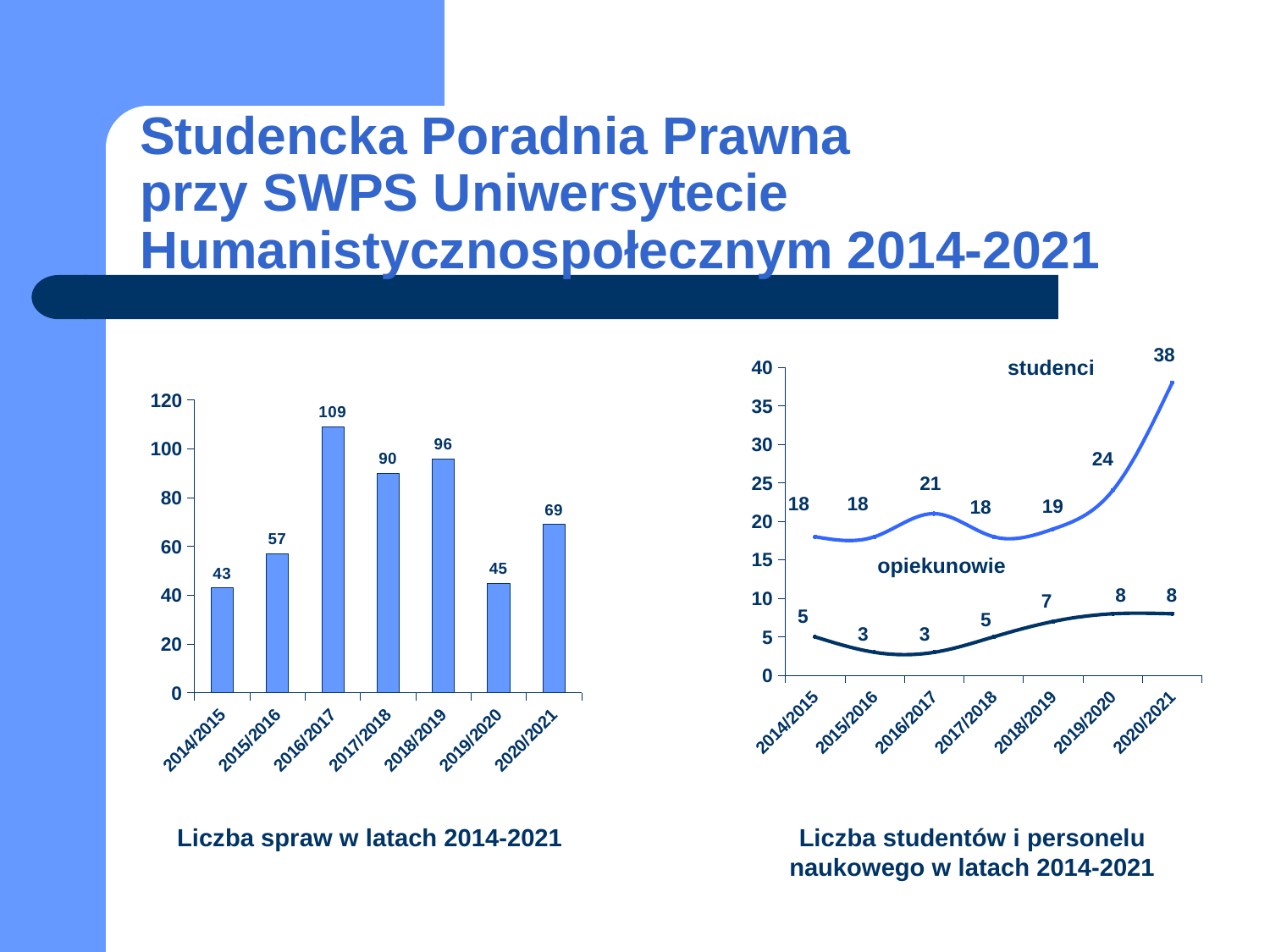
In the left chart (Liczba spraw w latach 2014-2021), what is the value for 2016/2017? 109 In the left chart (Liczba spraw w latach 2014-2021), which year has the highest value? 2016/2017 What kind of chart is the right chart (Liczba studentów i personelu naukowego w latach 2014-2021)? line chart In the right chart (Liczba studentów i personelu naukowego w latach 2014-2021), what is the value for studenci in 2020/2021? 38 In the right chart (Liczba studentów i personelu naukowego w latach 2014-2021), what is the difference between studenci and opiekunowie in 2019/2020? 16 In the right chart (Liczba studentów i personelu naukowego w latach 2014-2021), what is the value for opiekunowie in 2018/2019? 7 In the left chart (Liczba spraw w latach 2014-2021), how many years are shown on the x axis? 7 In the left chart (Liczba spraw w latach 2014-2021), what is the difference between the values for 2018/2019 and 2019/2020? 51 In the left chart (Liczba spraw w latach 2014-2021), which year has the lowest value? 2014/2015 What kind of chart is the left chart (Liczba spraw w latach 2014-2021)? bar chart In the right chart (Liczba studentów i personelu naukowego w latach 2014-2021), which year has the highest value for studenci? 2020/2021 In the right chart (Liczba studentów i personelu naukowego w latach 2014-2021), how many series are plotted? 2